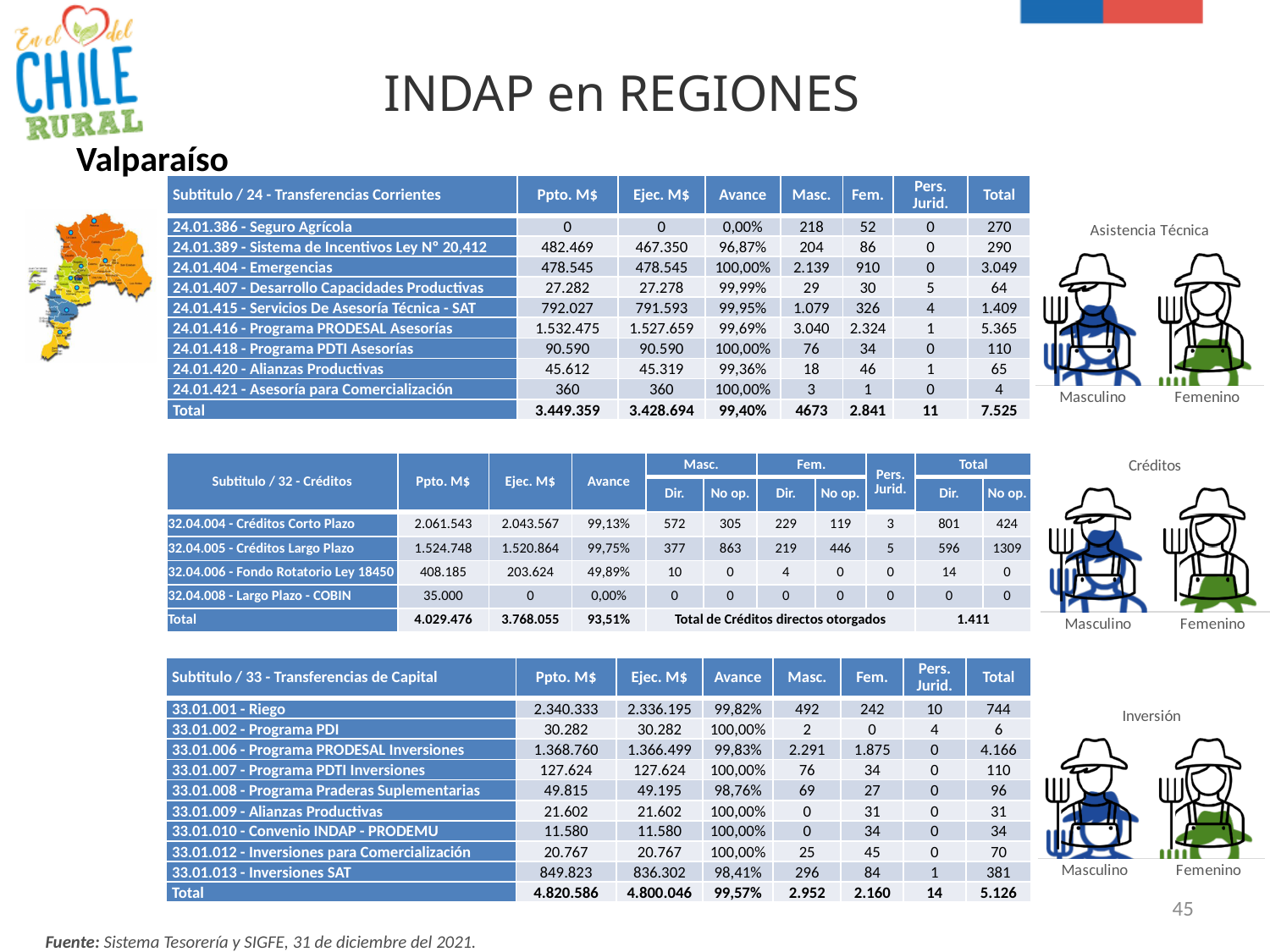
What is the title of the pictogram chart at the bottom right of the slide? Inversión In the Asistencia Técnica pictogram chart, what are the two categories labelled? Masculino and Femenino In the Créditos pictogram chart, which colour fills the Femenino figure? Green What kind of chart is used on the right side of the slide to show Masculino and Femenino? Pictogram chart In the Asistencia Técnica pictogram chart, which figure is filled to a higher level, Masculino or Femenino? Masculino In the Créditos pictogram chart, which figure is filled to a higher level, Masculino or Femenino? Masculino How many pictogram charts are shown on the right side of the slide? 3